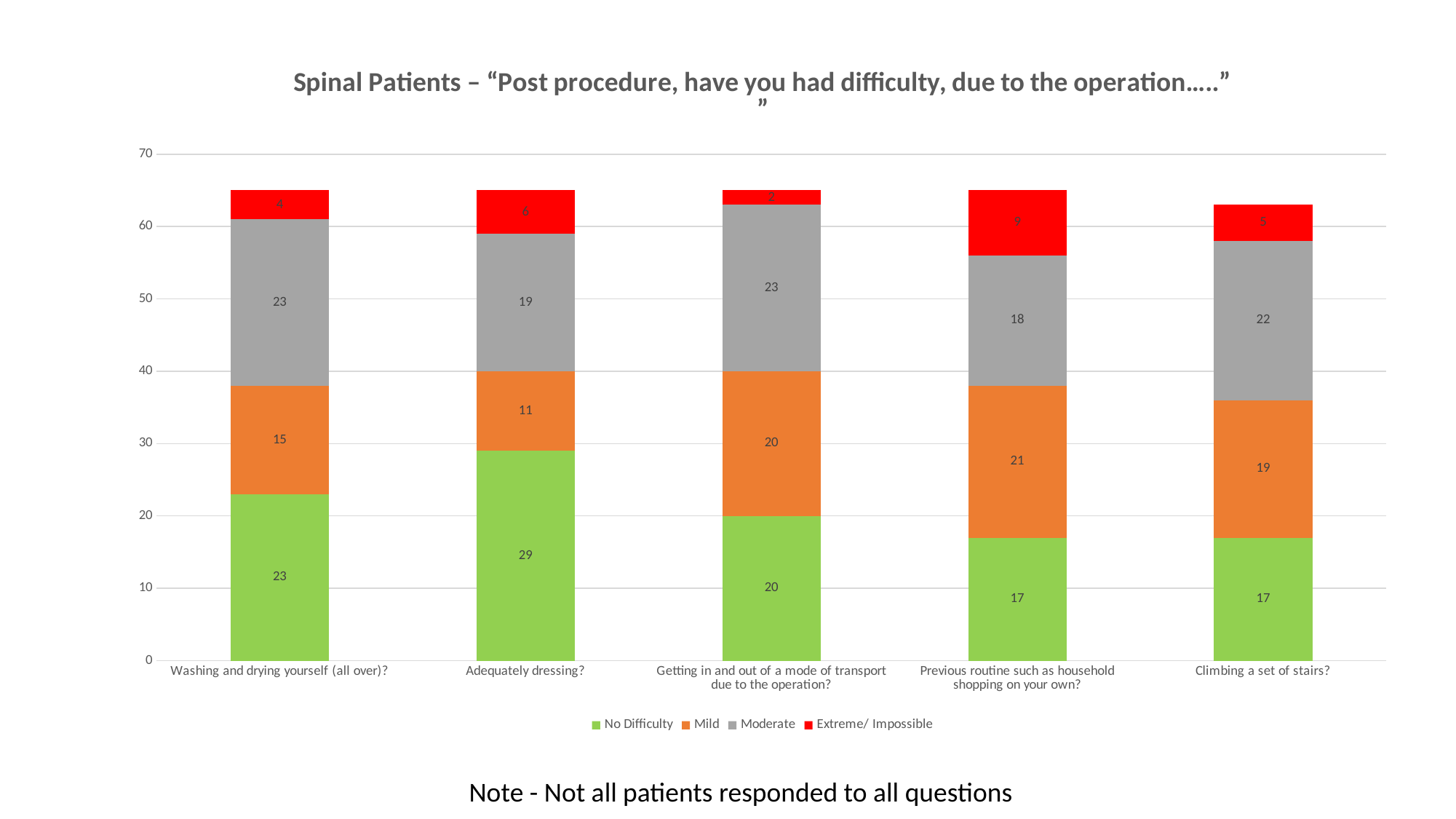
What is the difference between the Moderate values for "Washing and drying yourself (all over)?" and "Adequately dressing?"? 4 How many series does the legend list? 4 What kind of chart is shown on the slide? Stacked bar chart What is the No Difficulty value for "Adequately dressing?"? 29 What is the total of the stacked bar for "Climbing a set of stairs?"? 63 Which category has the lowest Extreme/ Impossible value? Getting in and out of a mode of transport due to the operation? Which category has the highest No Difficulty value? Adequately dressing? Which is larger: the Mild value for "Previous routine such as household shopping on your own?" or the Mild value for "Washing and drying yourself (all over)?"? Previous routine such as household shopping on your own? What is the Extreme/ Impossible value for "Previous routine such as household shopping on your own?"? 9 How many categories are shown on the x axis? 5 Which colour represents the Moderate series in the legend? Grey What is the Mild value for "Climbing a set of stairs?"? 19